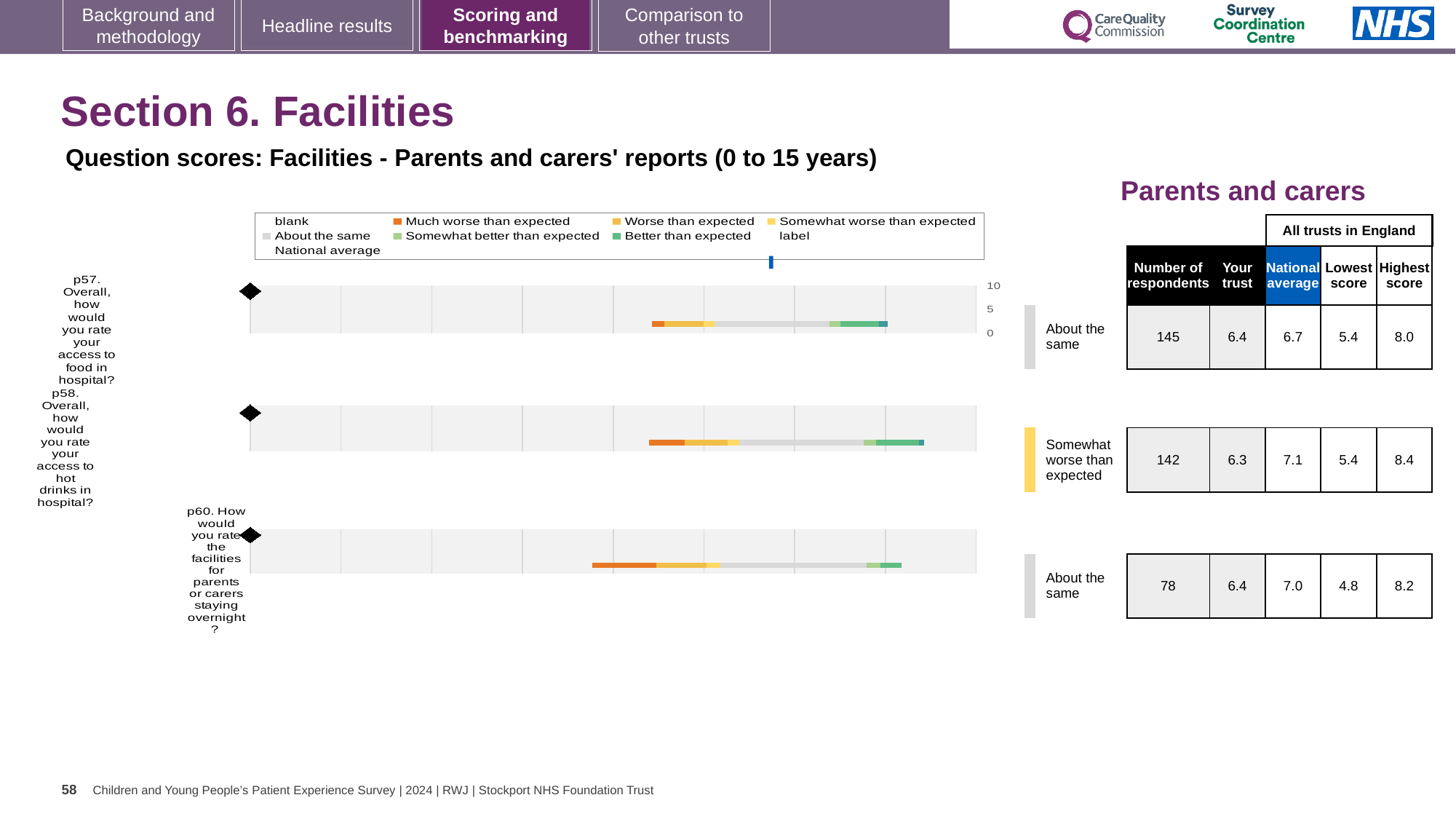
Which of the three questions has the highest number of respondents in the table? p57 According to the table next to the chart, how many respondents answered p60 (facilities for parents or carers staying overnight)? 78 What is the highest value shown on the chart's vertical axis? 10 What is the difference between the highest score and the lowest score for p57 in the table? 2.6 Which question has the lowest 'Lowest score' value in the table? p60 What kind of chart is used to show the question scores on this slide? bar chart How many survey questions are plotted in the chart area on this slide? 3 What benchmark category is given for p58 (access to hot drinks in hospital)? Somewhat worse than expected Which legend entry is shown in orange in the chart legend? Much worse than expected Is the national average for p58 larger or smaller than the national average for p57? larger According to the table next to the chart, what is the national average for p58 (access to hot drinks in hospital)? 7.1 According to the table next to the chart, what is the 'Your trust' score for p57 (access to food in hospital)? 6.4